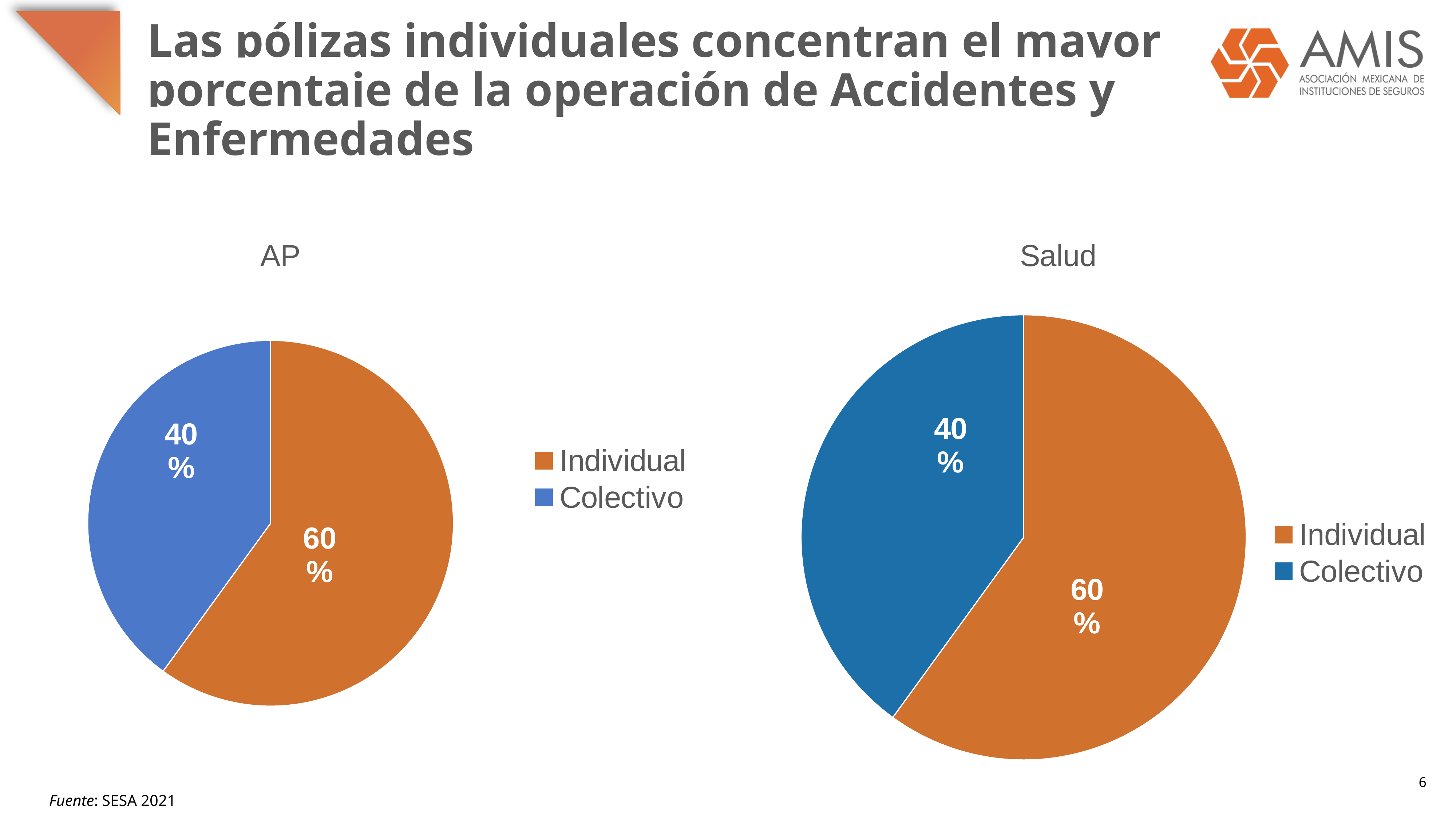
In the AP chart, what is the difference between the Individual and Colectivo shares? 20% How many entries does the legend of the AP chart list? 2 In the Salud chart, what is the value for Colectivo? 40% What kind of chart is the AP chart? Pie chart In the Salud chart, which category has the smallest share? Colectivo In the AP chart, what is the value for Individual? 60% In the AP chart, which category has the largest share? Individual In the Salud chart, which is larger, Individual or Colectivo? Individual In the Salud chart, what is the value for Individual? 60% In the Salud chart, what colour is the Individual slice? Orange How many slices does the Salud chart have? 2 In the AP chart, what is the value for Colectivo? 40%